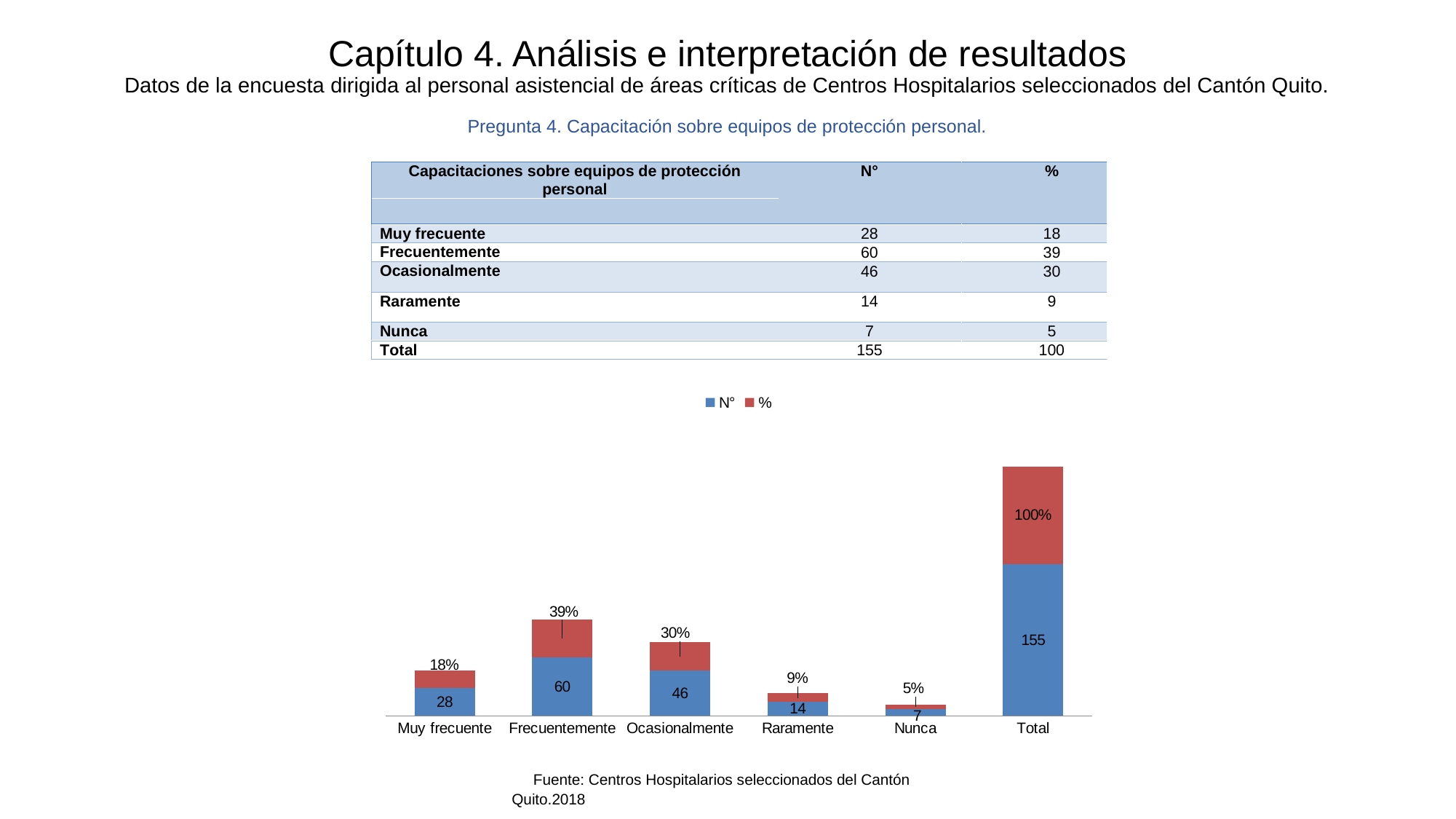
How many categories are shown on the x axis of the chart? 6 How many series does the chart legend list? 2 What is the % value shown for Ocasionalmente in the chart? 30% What is the N° value for Frecuentemente in the chart? 60 Which category has the lowest N° value in the chart? Nunca What is the difference between the N° values for Frecuentemente and Ocasionalmente? 14 What is the N° value for Nunca in the chart? 7 Excluding the Total bar, which category has the highest N° value? Frecuentemente What is the % value shown for Raramente in the chart? 9% What type of chart is shown on the slide? Bar chart What are the two entries in the chart legend? N° and % Which has a larger N° value, Muy frecuente or Raramente? Muy frecuente